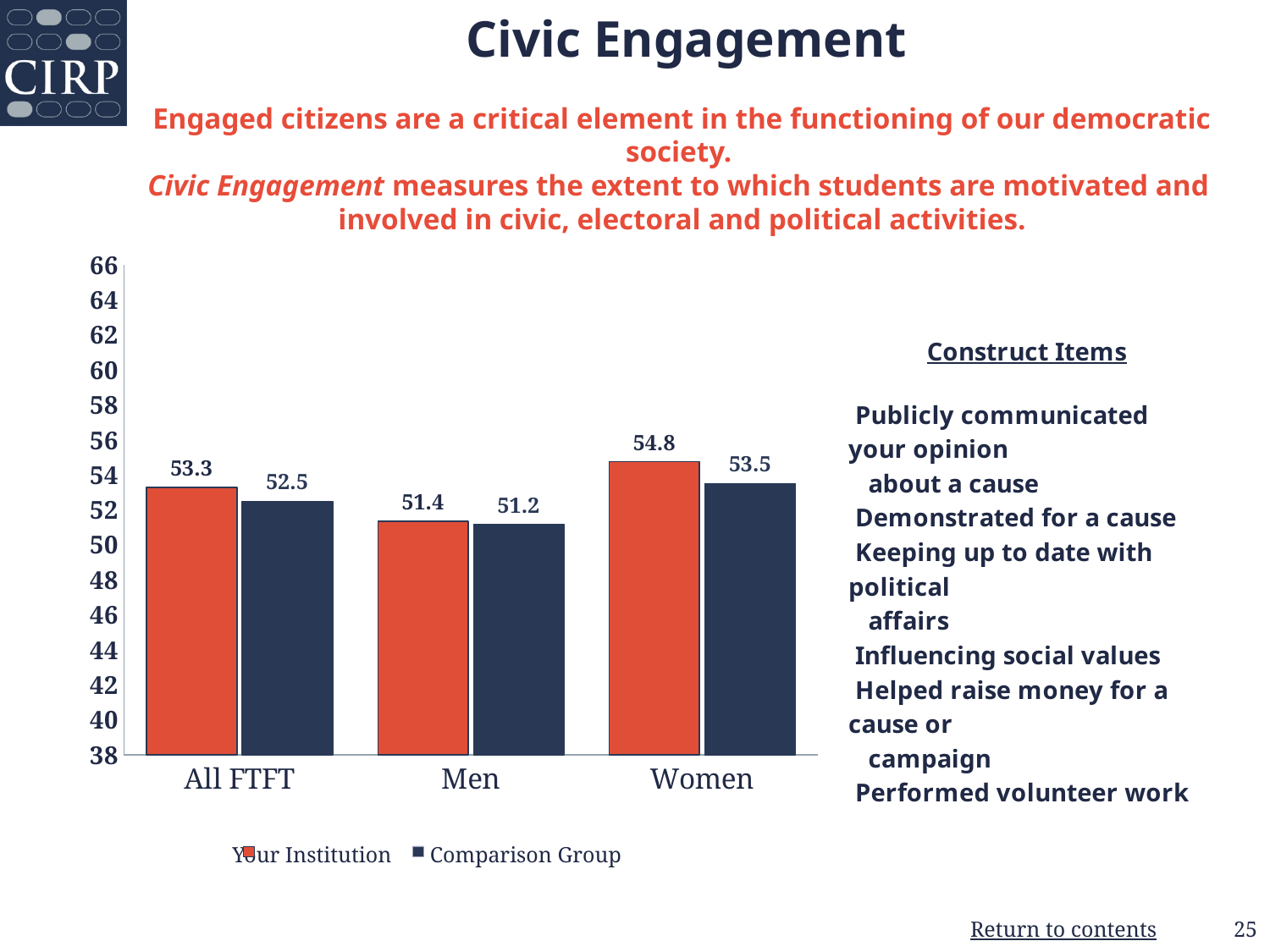
How many series does the legend list? 2 Is the Comparison Group value for Women greater or less than 52? greater Which category has the highest Your Institution value? Women What is the Comparison Group value for Men? 51.2 Which is larger for All FTFT: Your Institution or Comparison Group? Your Institution What is the Your Institution value for All FTFT? 53.3 What is the difference between the Your Institution values for Women and Men? 3.4 Which category has the lowest Comparison Group value? Men What is the Your Institution value for Women? 54.8 What kind of chart is shown on the slide? bar chart How many categories are shown on the x axis? 3 What is the difference between the Your Institution and Comparison Group values for Women? 1.3